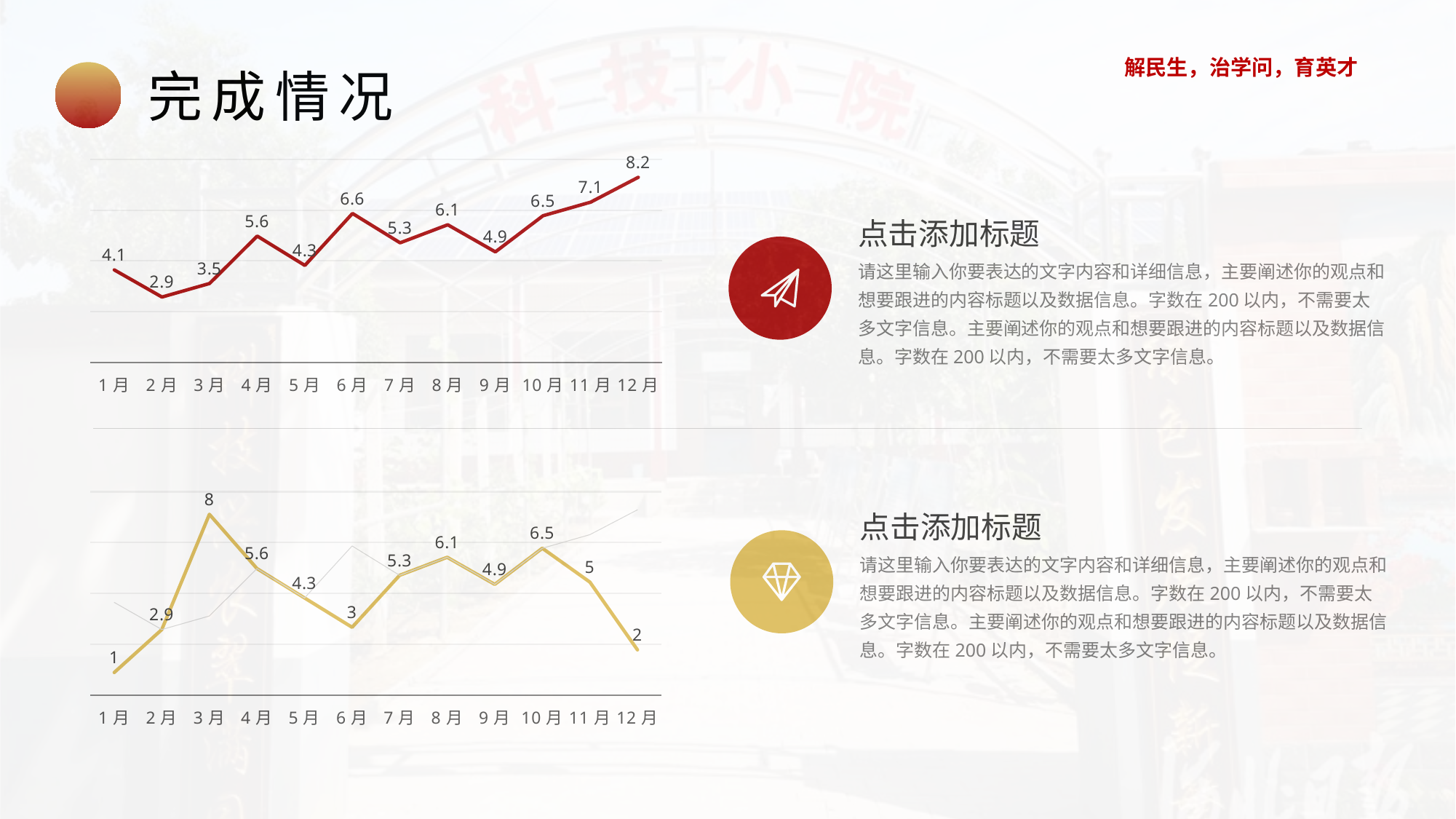
In the top chart, what is the value for 6月? 6.6 In the top chart, what is the value for 12月? 8.2 In the bottom chart, which month has the lowest value on the gold line? 1月 What kind of chart is the bottom chart? line chart In the top chart, which is larger, the value for 4月 or the value for 5月? 4月 How many months are plotted on the x axis of the top chart? 12 In the bottom chart, which is larger, the value for 10月 or the value for 11月 on the gold line? 10月 In the bottom chart, what is the value for 3月? 8 In the top chart, which month has the highest value? 12月 In the bottom chart, what is the difference between the values for 3月 and 6月 on the gold line? 5 In the top chart, which month has the lowest value? 2月 In the top chart, what is the difference between the values for 12月 and 1月? 4.1